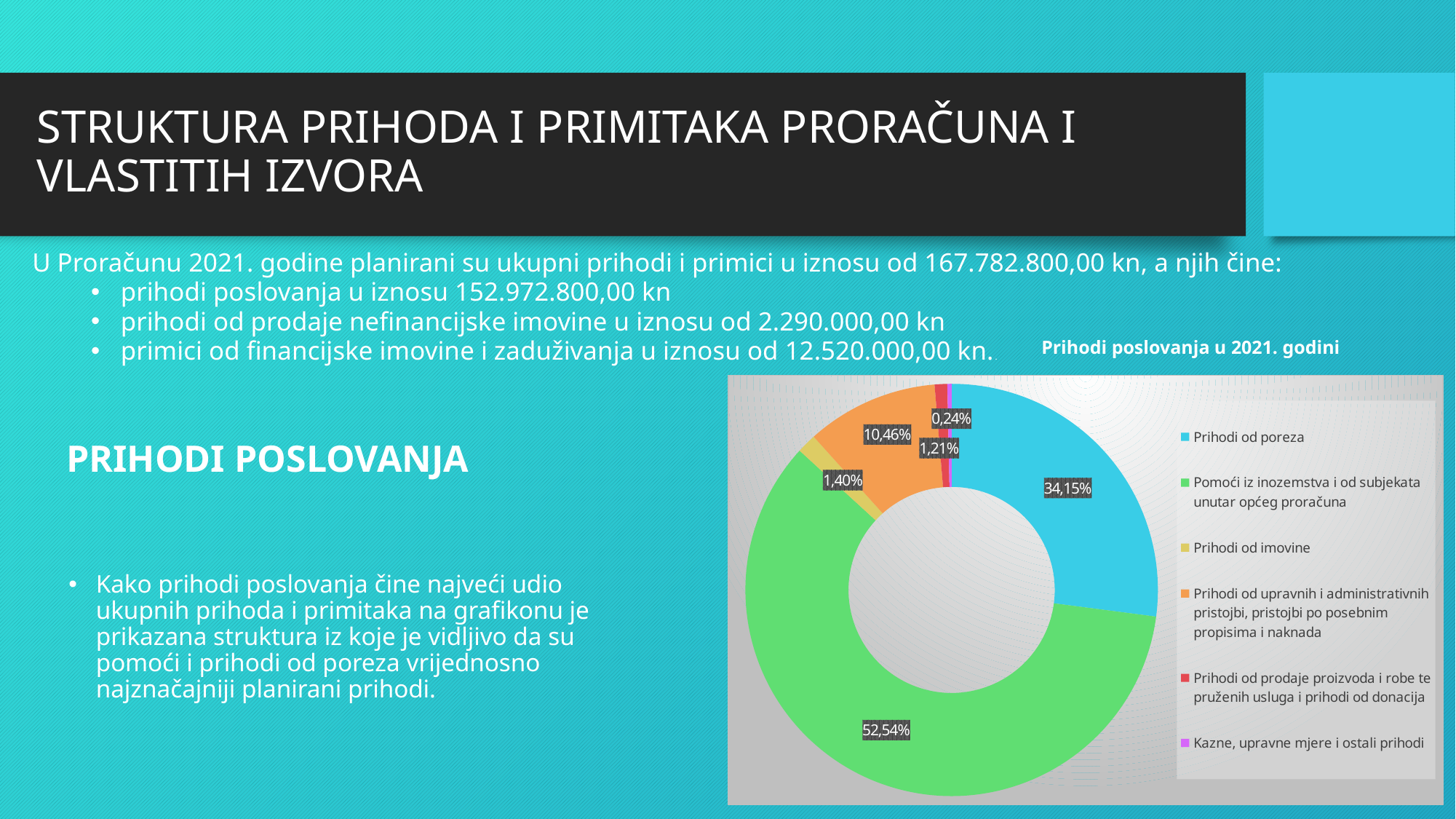
What is the difference in percentage points between the share for Pomoći iz inozemstva i od subjekata unutar općeg proračuna and the share for Prihodi od poreza? 18,39 What share is shown for Kazne, upravne mjere i ostali prihodi? 0,24% Which is larger: the share for Prihodi od poreza or the share for Prihodi od upravnih i administrativnih pristojbi, pristojbi po posebnim propisima i naknada? Prihodi od poreza What share is shown for Prihodi od imovine? 1,40% What is the title of the chart? Prihodi poslovanja u 2021. godini What type of chart is shown on the slide? Doughnut chart What share is shown for Prihodi od upravnih i administrativnih pristojbi, pristojbi po posebnim propisima i naknada? 10,46% Which category has the largest share of the chart? Pomoći iz inozemstva i od subjekata unutar općeg proračuna What share is shown for Pomoći iz inozemstva i od subjekata unutar općeg proračuna? 52,54% What share of the chart is labelled for Prihodi od poreza? 34,15% How many categories does the legend list? 6 Which category has the smallest share of the chart? Kazne, upravne mjere i ostali prihodi